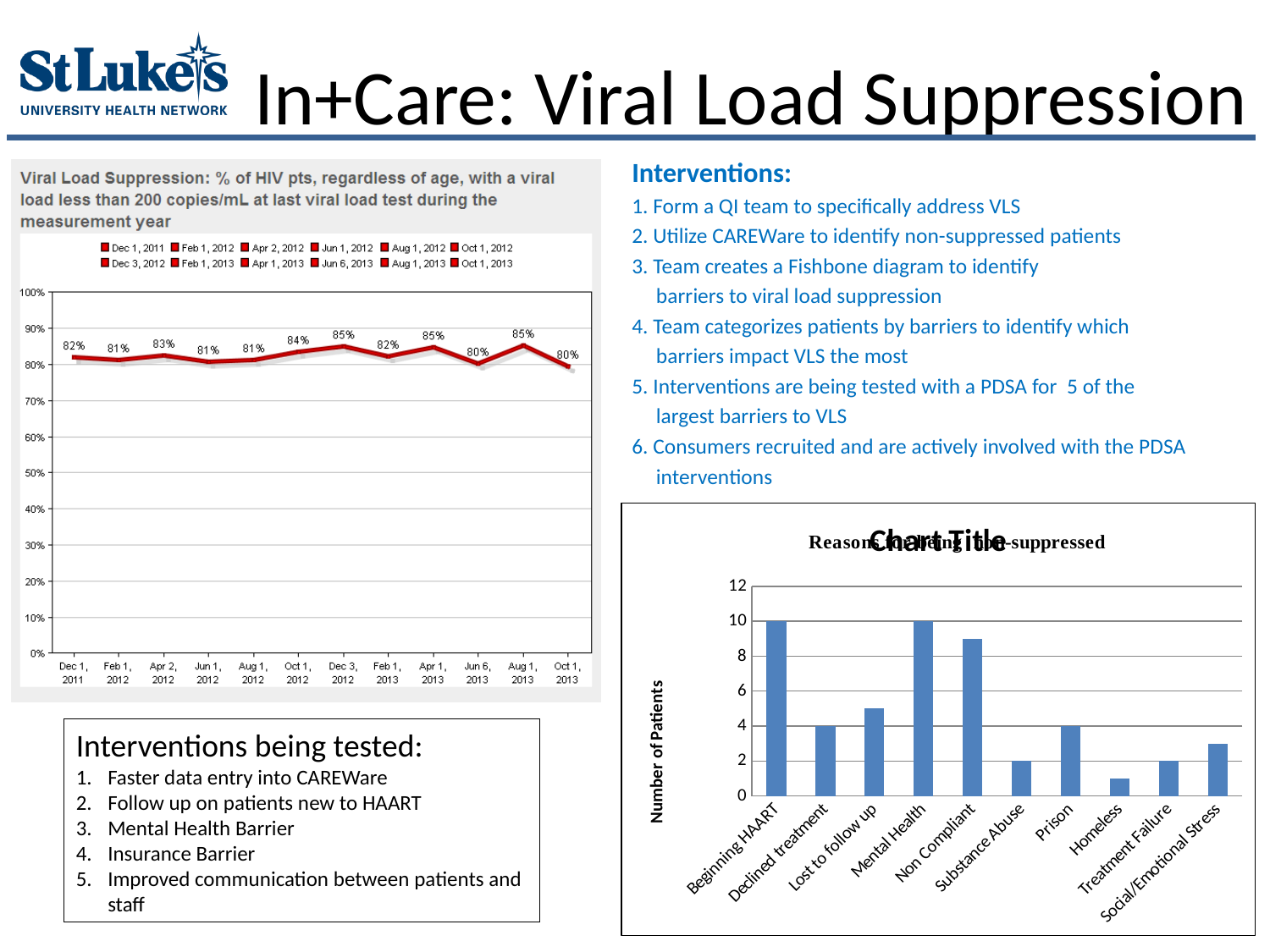
In the Viral Load Suppression chart on the left, what is the value for Dec 1, 2011? 82% In the bar chart on the right, which category has the lowest number of patients? Homeless In the Viral Load Suppression chart on the left, is the value for Oct 1, 2013 greater or less than 70%? greater In the bar chart on the right, what is the number of patients for Substance Abuse? 2 In the Viral Load Suppression chart on the left, which is larger, the value for Apr 2, 2012 or the value for Oct 1, 2012? Oct 1, 2012 In the Viral Load Suppression chart on the left, what is the difference between the values for Dec 3, 2012 and Feb 1, 2013? 3% In the Viral Load Suppression chart on the left, how many data points are plotted? 12 In the bar chart on the right, is the value for Non Compliant greater or less than 8? greater In the bar chart on the right, how many categories are shown on the x axis? 10 What type of chart is the chart on the right of the slide? Bar chart In the bar chart on the right, what is the number of patients for Beginning HAART? 10 In the Viral Load Suppression chart on the left, what is the value for Jun 6, 2013? 80%